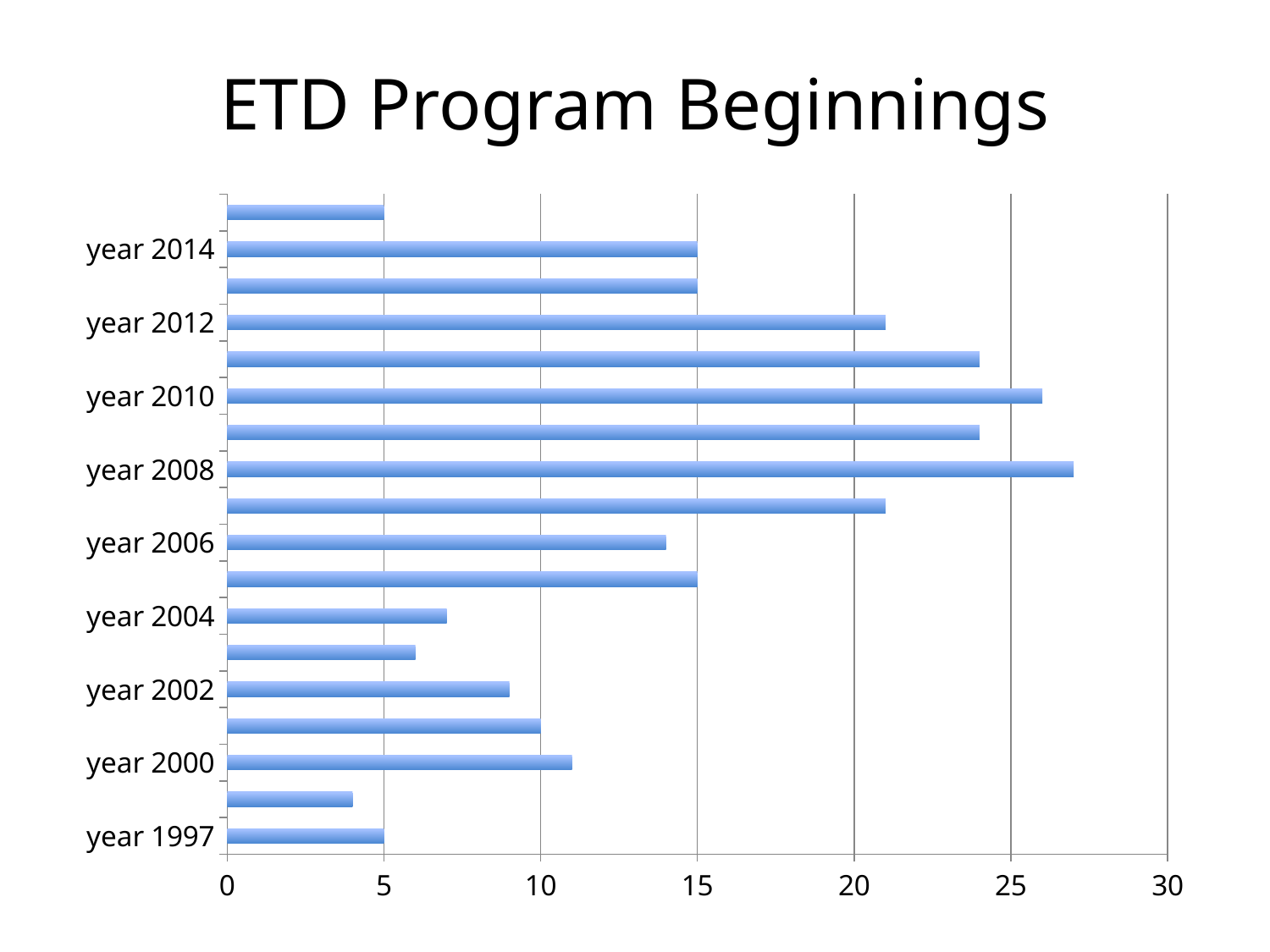
Which has a larger value, year 2008 or year 2006? year 2008 What is the value for year 2014? 15 What kind of chart is shown on the slide? bar chart Is the value for year 2006 greater or less than 15? less What is the difference between the values for year 2014 and year 1997? 10 Is the value for year 2008 greater or less than 25? greater What is the title of the chart? ETD Program Beginnings What is the value for year 1997? 5 How many bars are plotted in the chart? 18 Which has a larger value, year 2000 or year 1997? year 2000 Is the value for year 2004 greater or less than 10? less